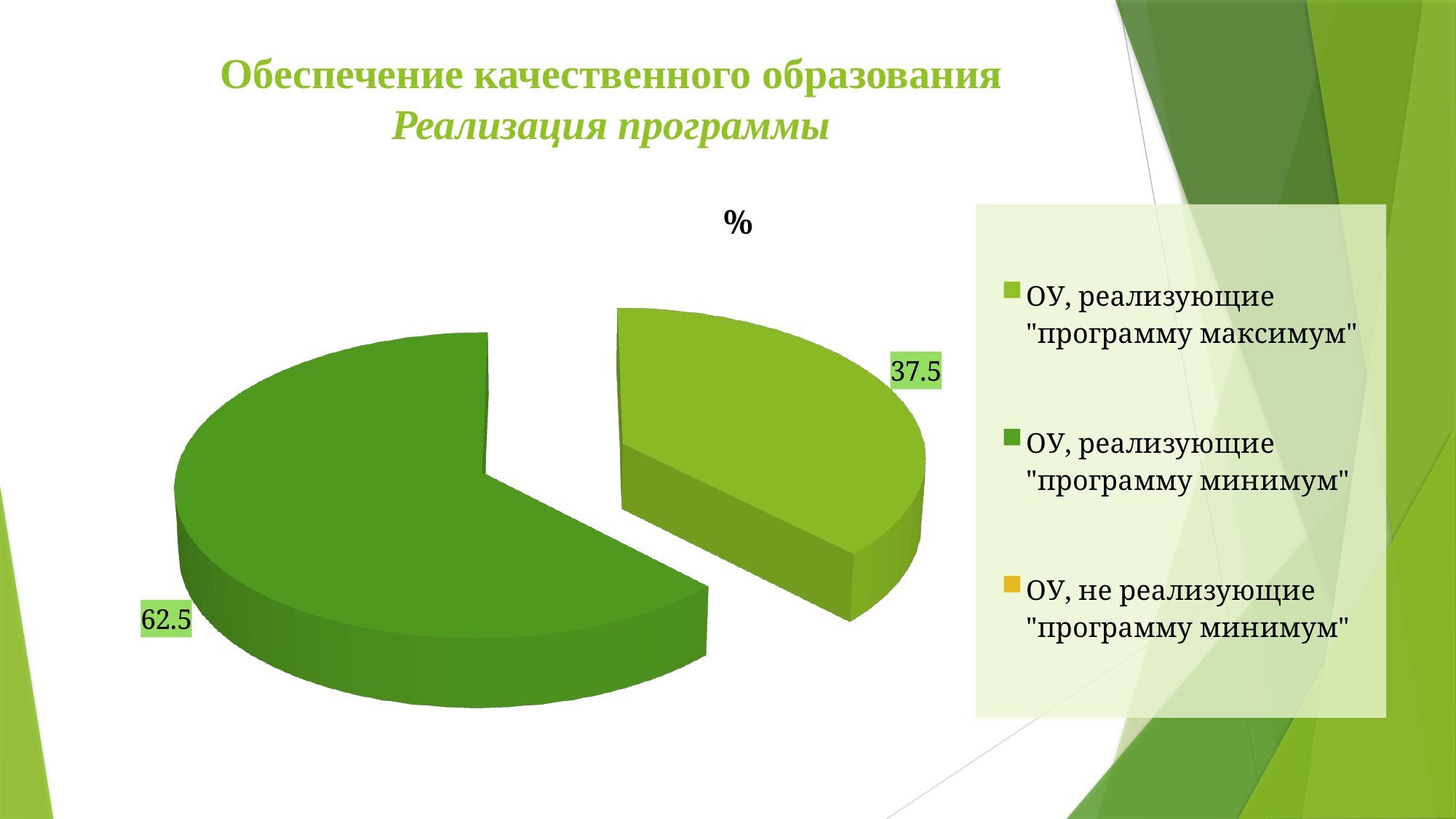
What colour is the legend marker for ОУ, не реализующие "программу минимум"? orange What kind of chart is shown on the slide? pie chart What is the total of the two labelled slices in the pie chart? 100 How many slices with data labels are visible in the pie chart? 2 How many entries does the legend list? 3 What is the difference between the values for ОУ, реализующие "программу минимум" and ОУ, реализующие "программу максимум"? 25 Which of the two visible slices is smaller? ОУ, реализующие "программу максимум" Which category has the largest slice of the pie? ОУ, реализующие "программу минимум" What is the value for ОУ, реализующие "программу максимум"? 37.5 Which is larger: the value for ОУ, реализующие "программу максимум" or the value for ОУ, реализующие "программу минимум"? ОУ, реализующие "программу минимум" What is the title of the chart? % What is the value for ОУ, реализующие "программу минимум"? 62.5